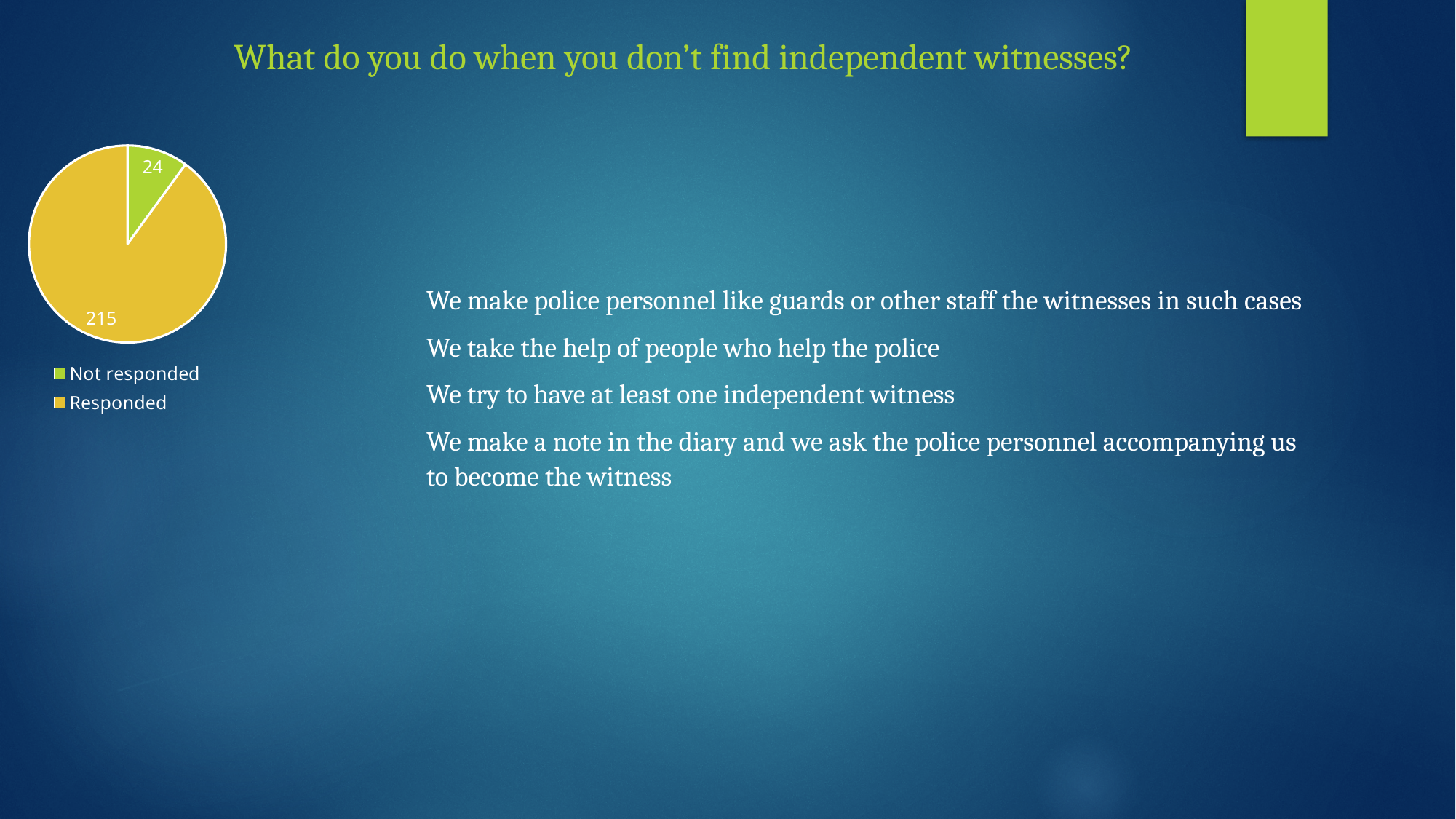
How many slices does the pie chart have? 2 Which category has the largest slice in the pie chart? Responded How many respondents are shown in the "Responded" slice of the pie chart? 215 What colour is the "Responded" slice in the pie chart? Yellow Which is larger in the pie chart, "Responded" or "Not responded"? Responded What is the difference between the "Responded" and "Not responded" values in the pie chart? 191 What is the total of the two values shown in the pie chart? 239 What value is shown for the "Not responded" slice of the pie chart? 24 What colour is the "Not responded" slice in the pie chart? Green How many entries does the legend of the pie chart list? 2 Which category has the smallest slice in the pie chart? Not responded What type of chart is shown on the slide? Pie chart